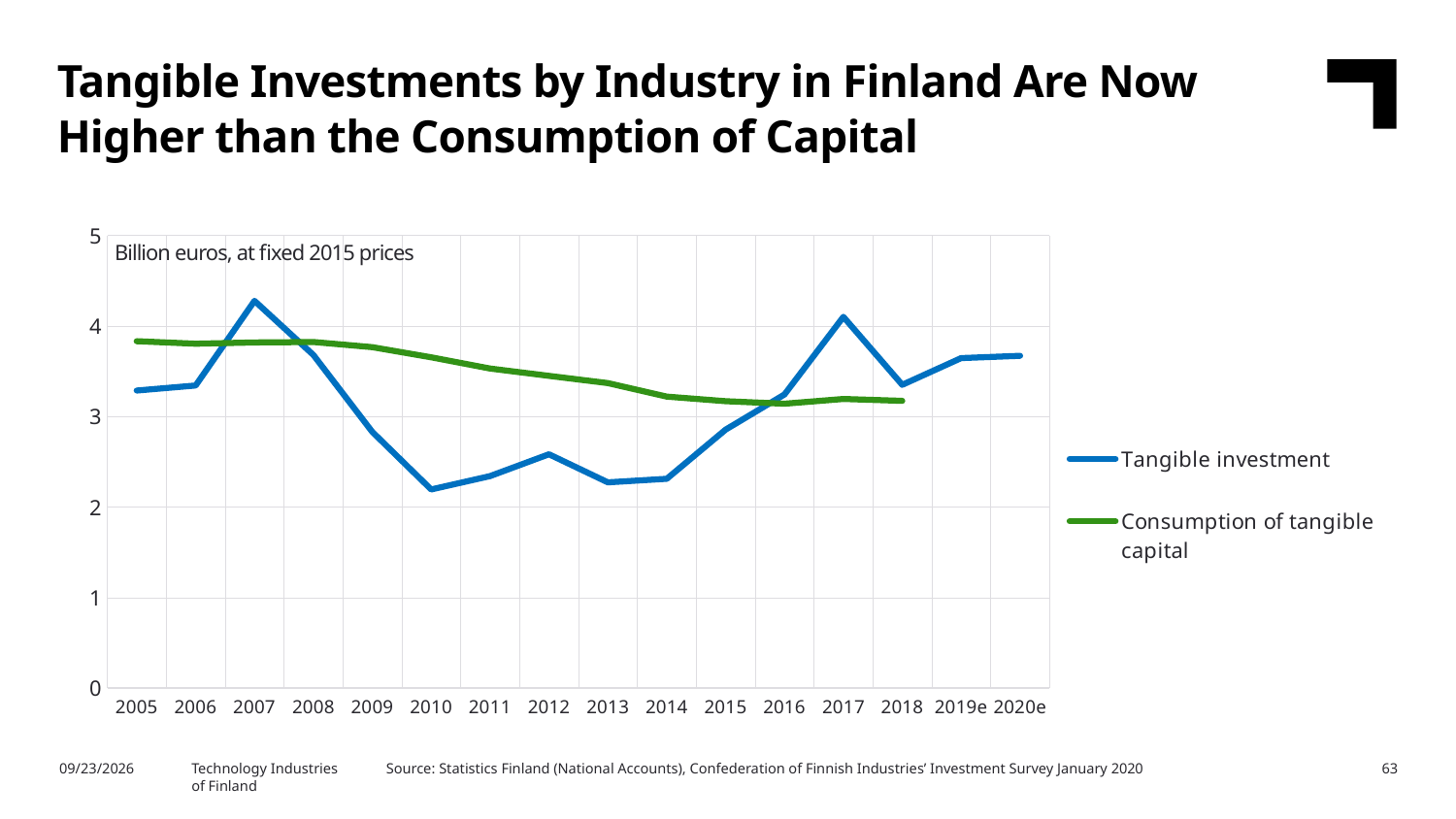
What unit is stated in the label inside the chart area? Billion euros, at fixed 2015 prices How many series does the legend list? 2 Is the value for Consumption of tangible capital in 2005 greater or less than 4? less What kind of chart is shown on the slide? Line chart Is the value for Consumption of tangible capital in 2018 greater or less than 3? greater Does the Consumption of tangible capital line rise or fall from 2005 to 2016? Fall How many years are shown along the x axis? 16 In which year does the Tangible investment line reach its highest value? 2007 Is the value for Tangible investment in 2007 greater or less than 4? greater In 2017, which is larger: Tangible investment or Consumption of tangible capital? Tangible investment In 2010, which is larger: Tangible investment or Consumption of tangible capital? Consumption of tangible capital